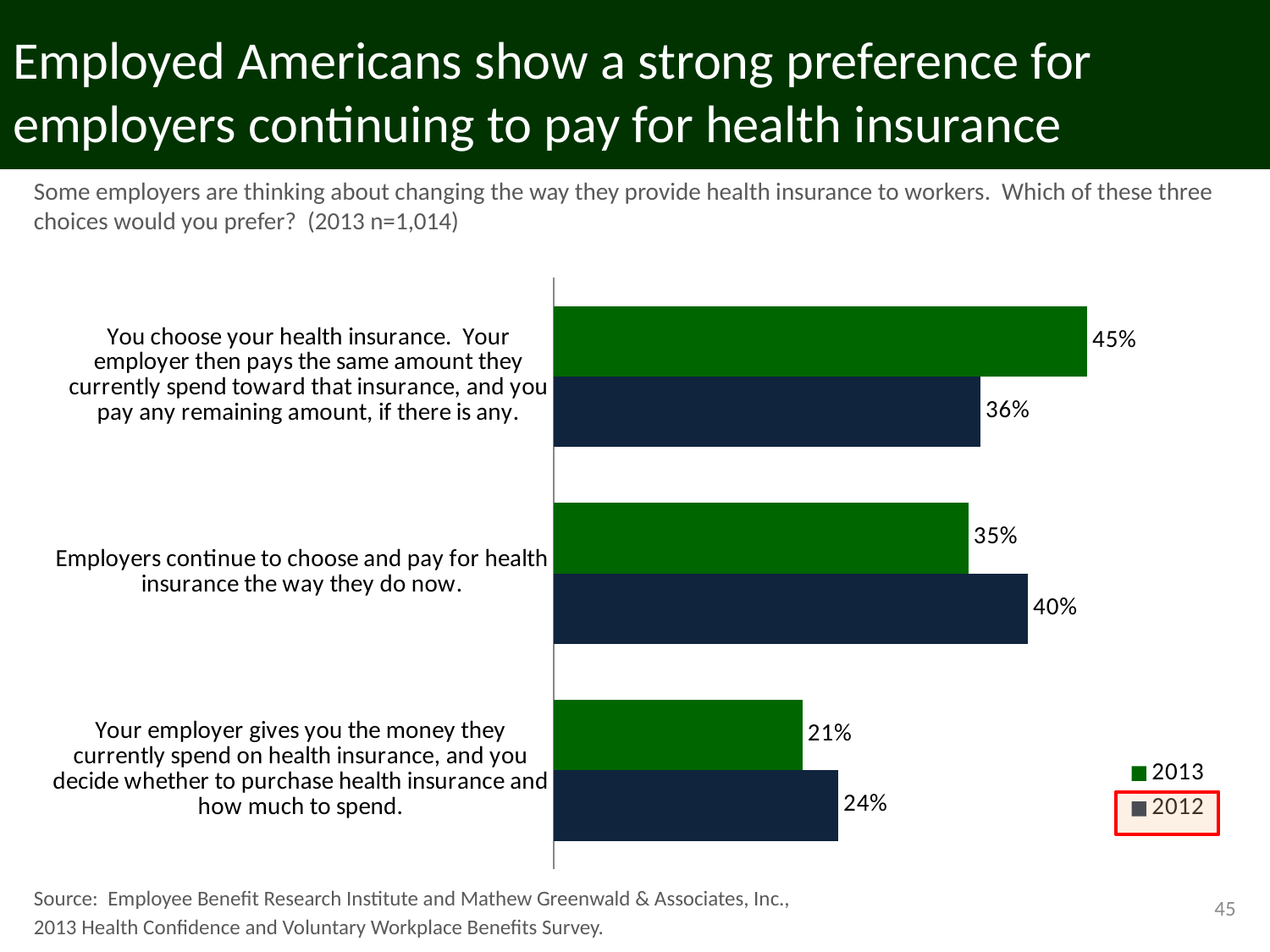
What is the 2013 value for "Employers continue to choose and pay for health insurance the way they do now"? 35% What is the difference between the 2012 and 2013 values for "Your employer gives you the money they currently spend on health insurance..."? 3 percentage points Which option has the lowest 2012 value? Your employer gives you the money they currently spend on health insurance, and you decide whether to purchase health insurance and how much to spend. How many response options are shown on the chart? 3 For "Employers continue to choose and pay for health insurance the way they do now", which year has the larger value, 2013 or 2012? 2012 What is the difference between the 2013 and 2012 values for "You choose your health insurance..."? 9 percentage points What is the 2012 value for "Your employer gives you the money they currently spend on health insurance, and you decide whether to purchase health insurance and how much to spend"? 24% Which option has the highest 2013 value? You choose your health insurance. Your employer then pays the same amount they currently spend toward that insurance, and you pay any remaining amount, if there is any. Which colour represents the 2013 series in the legend? Green How many series does the legend list? 2 What kind of chart is shown on the slide? Bar chart What is the 2012 value for "You choose your health insurance. Your employer then pays the same amount they currently spend toward that insurance, and you pay any remaining amount, if there is any"? 36%